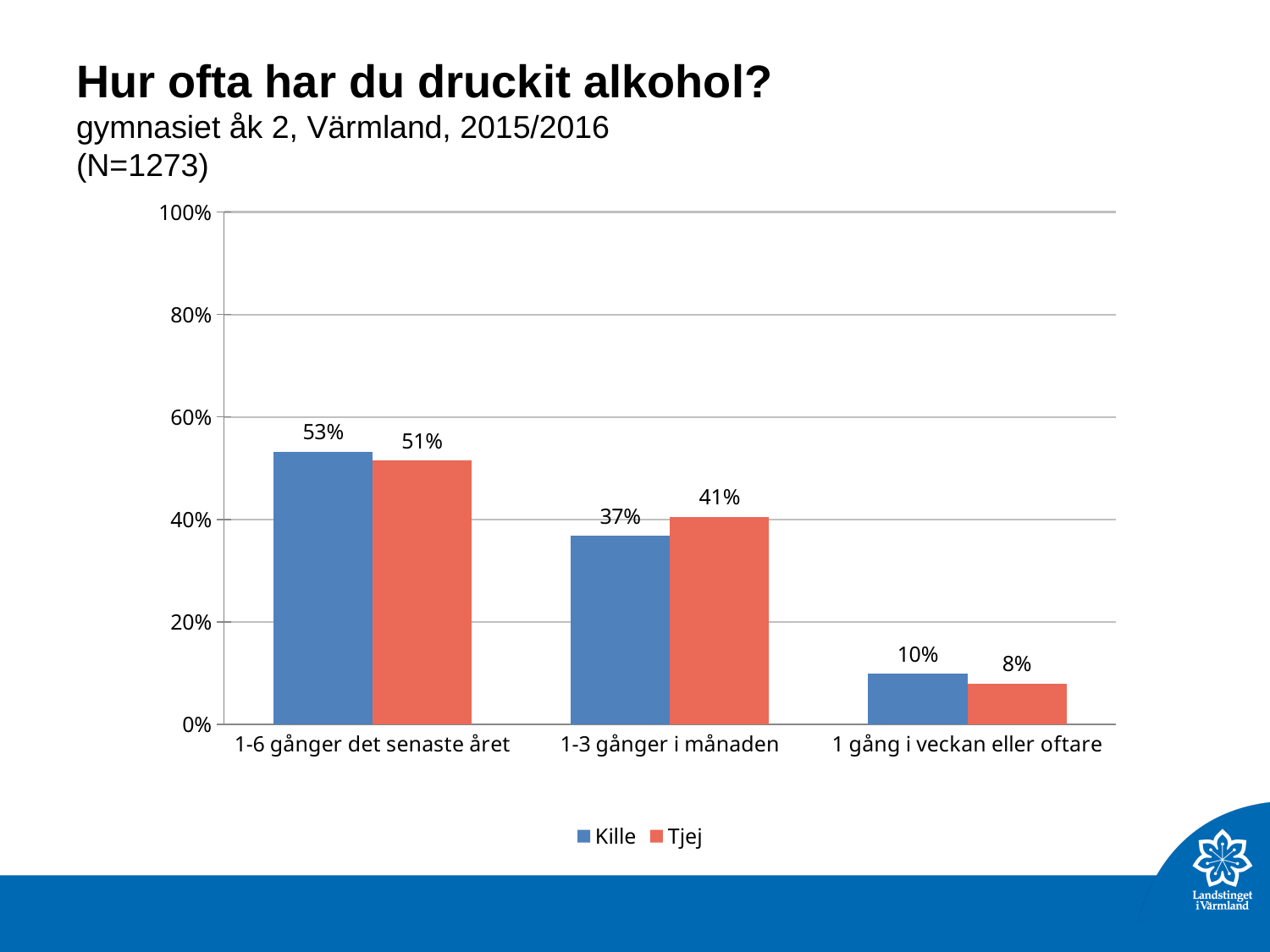
What is the value for Tjej in the category "1 gång i veckan eller oftare"? 8% What is the value for Kille in the category "1-6 gånger det senaste året"? 53% Which category has the highest value for Kille? 1-6 gånger det senaste året What kind of chart is shown on the slide? Bar chart How many series does the legend list? 2 What is the difference between Tjej and Kille in the category "1-3 gånger i månaden"? 4% What is the value for Tjej in the category "1-3 gånger i månaden"? 41% Do the values for Kille rise or fall from left to right along the x axis? Fall Is the value for Kille in "1-3 gånger i månaden" greater or less than 40%? less How many categories are shown on the x axis? 3 In the category "1 gång i veckan eller oftare", which series has the larger value, Kille or Tjej? Kille Which category has the lowest value for Tjej? 1 gång i veckan eller oftare